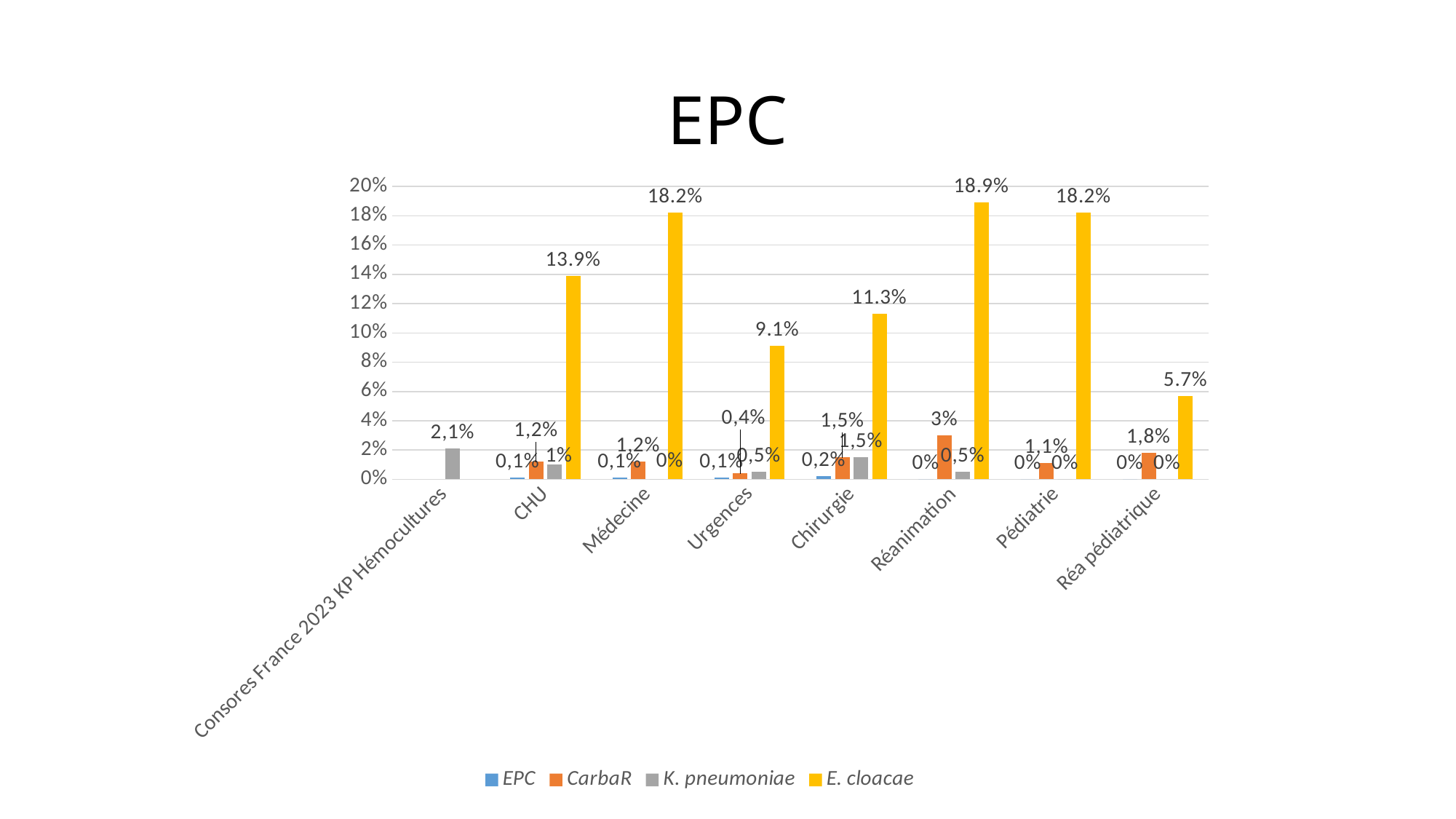
What is the difference between the E. cloacae values for Réanimation and Réa pédiatrique? 13.2% Is the E. cloacae value for Médecine greater or less than 16%? greater What is the K. pneumoniae value for Consores France 2023 KP Hémocultures? 2,1% Which category has the highest CarbaR value? Réanimation Which category has the lowest E. cloacae value among those with an E. cloacae bar? Réa pédiatrique Which is larger, the E. cloacae value for CHU or for Chirurgie? CHU Which category has the highest E. cloacae value? Réanimation What kind of chart is shown on the slide? bar chart What is the CarbaR value for Réa pédiatrique? 1,8% How many categories are shown on the x axis? 8 How many series does the legend list? 4 What is the E. cloacae value for Réanimation? 18.9%